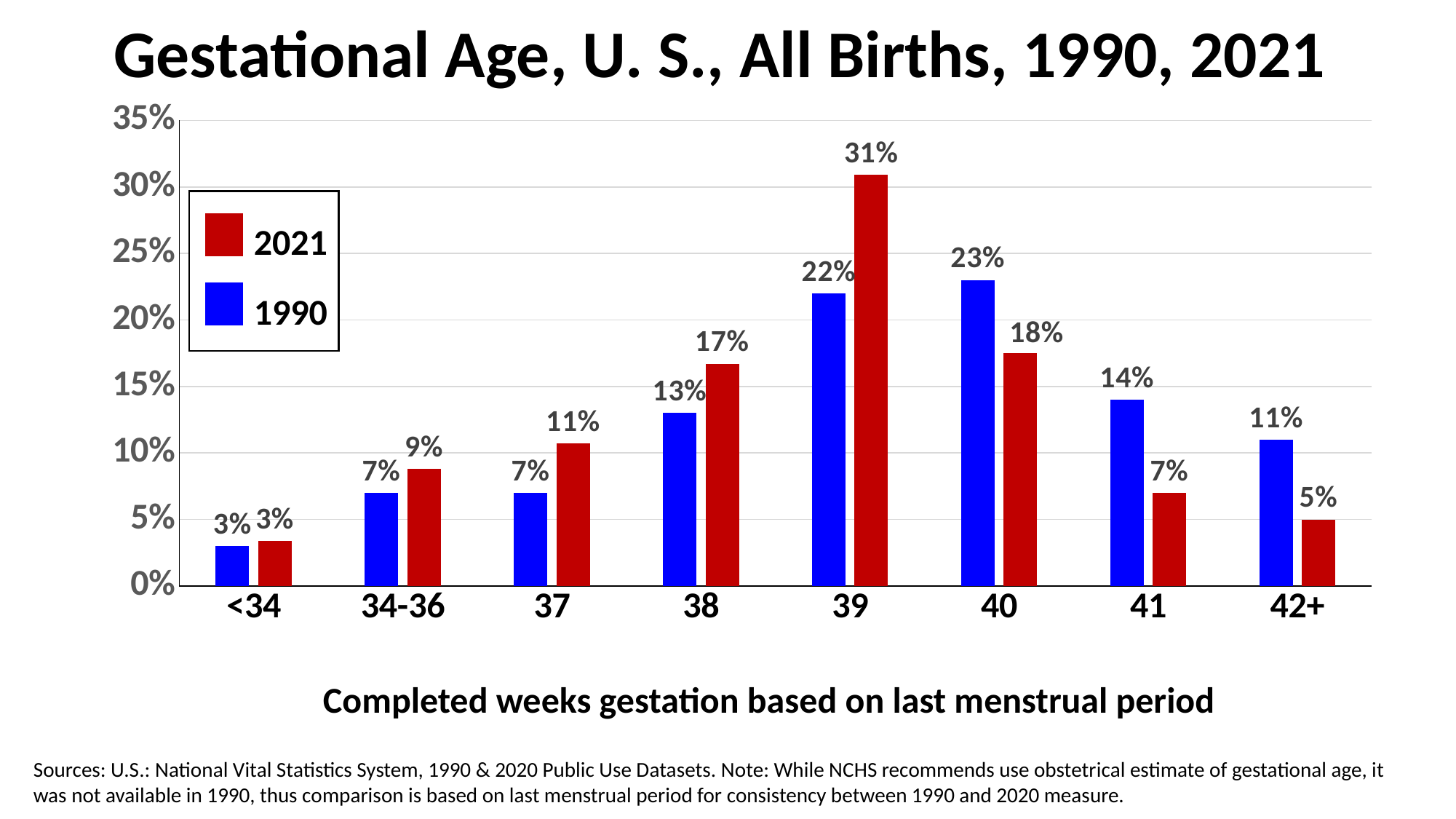
What is the difference between the 2021 and 1990 values for 39 completed weeks? 9% How many series does the legend list? 2 Which gestational age category has the highest 2021 value? 39 Is the 2021 value for 40 completed weeks greater or less than 20%? less Which gestational age category has the lowest 1990 value? <34 What is the 2021 value for 39 completed weeks? 31% Which is larger for 41 completed weeks, the 1990 value or the 2021 value? 1990 What kind of chart is shown on the slide? bar chart How many gestational age categories are shown on the x axis? 8 What is the 1990 value for 40 completed weeks? 23% What is the 2021 value for 42+ completed weeks? 5% Which colour represents the 2021 series in the legend? red